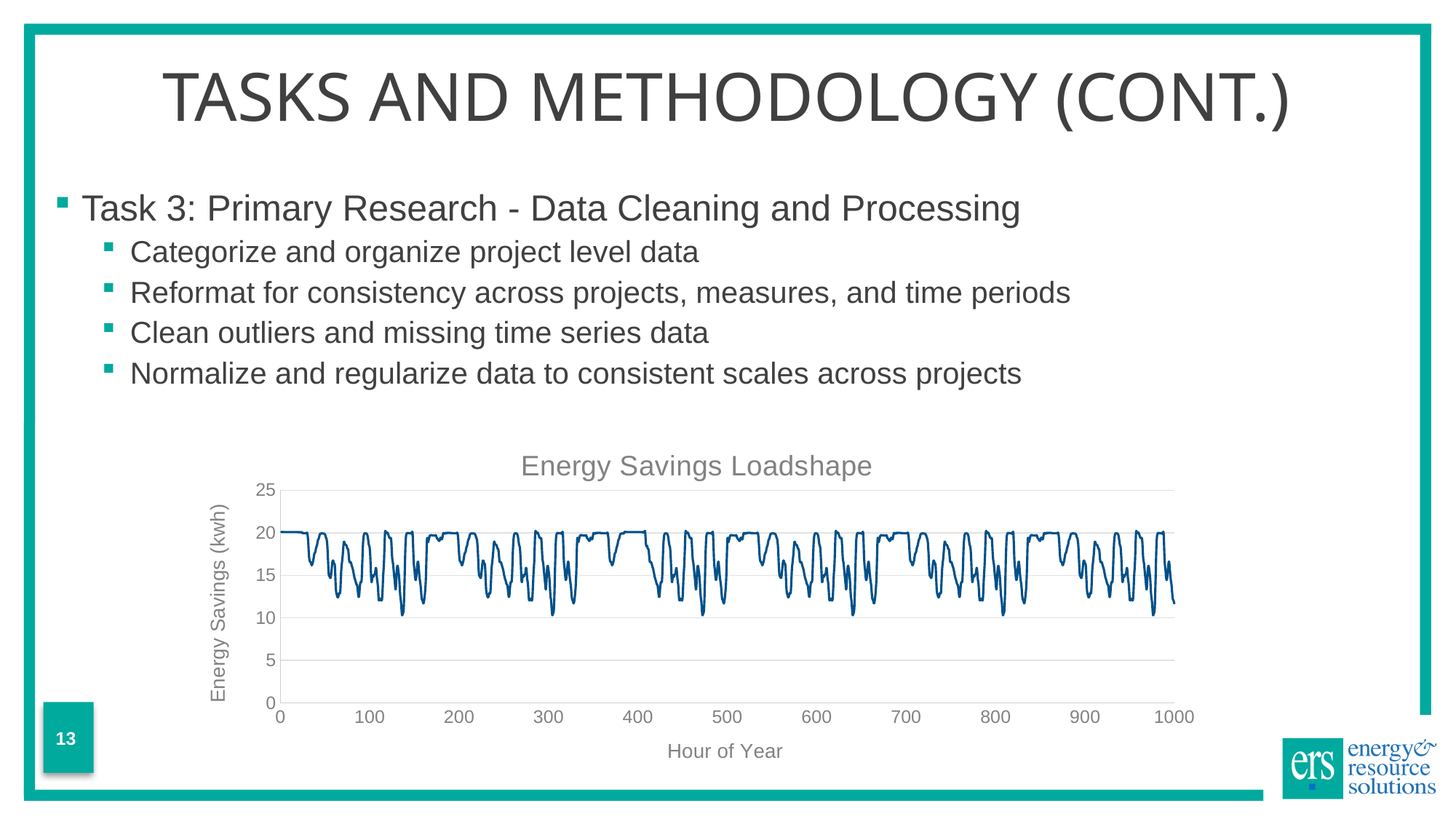
Is the highest value plotted on the chart greater or less than 25? less What kind of chart is shown on the slide? line chart Do the values steadily rise, steadily fall, or fluctuate along the x axis? fluctuate What is the title of the chart? Energy Savings Loadshape Is the lowest value plotted on the chart greater or less than 5? greater What is the label of the x axis of the chart? Hour of Year Is the value at hour 0 greater or less than 15? greater